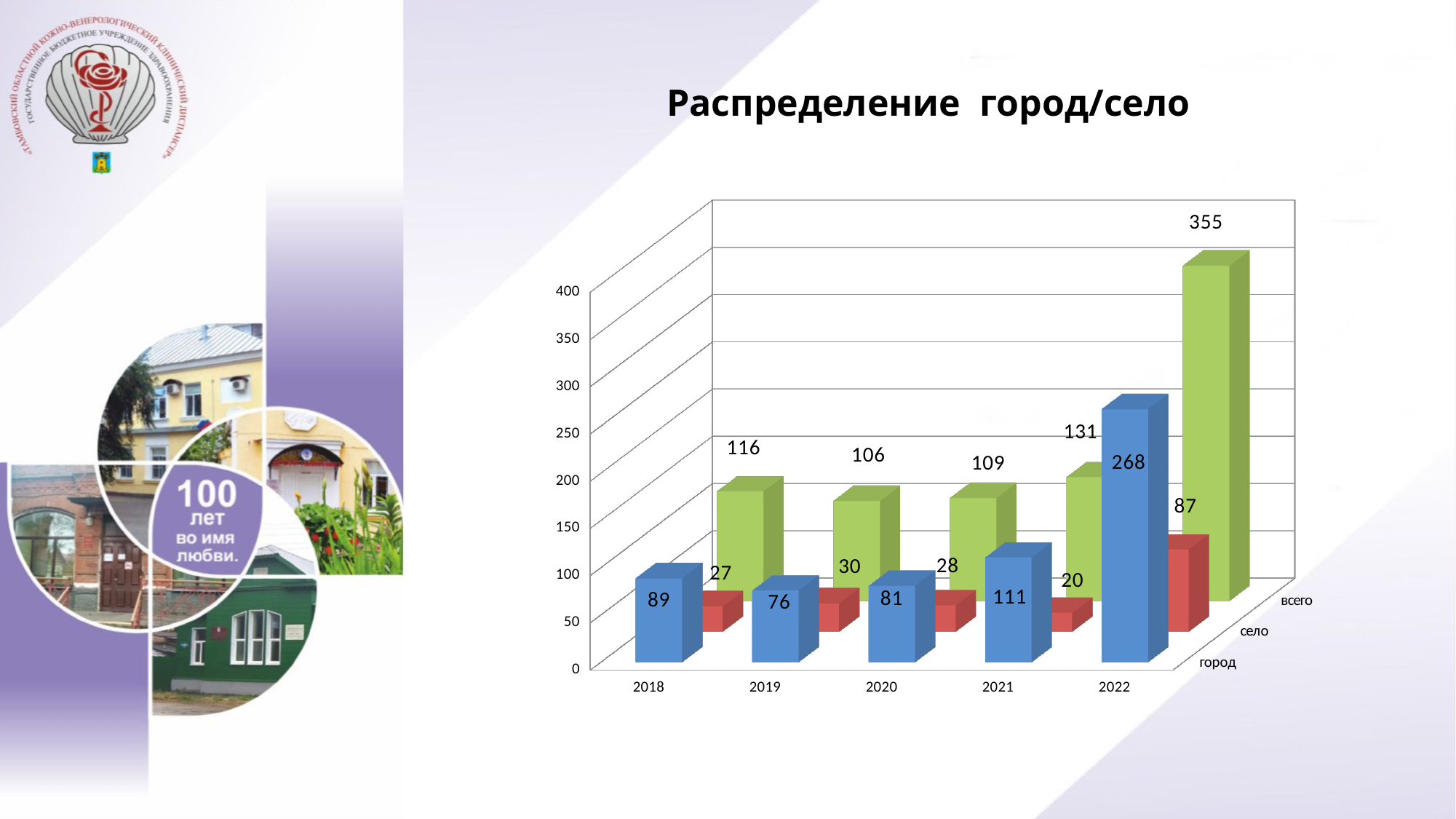
What is the difference between the всего values for 2022 and 2021? 224 What is the value for всего in 2021? 131 What kind of chart is shown on the slide? bar chart Which year has the highest value for всего? 2022 Which year has the lowest value for село? 2021 What is the title of the chart? Распределение город/село What is the value for город in 2022? 268 What is the value for село in 2019? 30 How many years are shown on the x axis? 5 Which is larger, the город value in 2020 or the город value in 2021? 2021 Which year has the lowest value for город? 2019 What is the value for город in 2018? 89